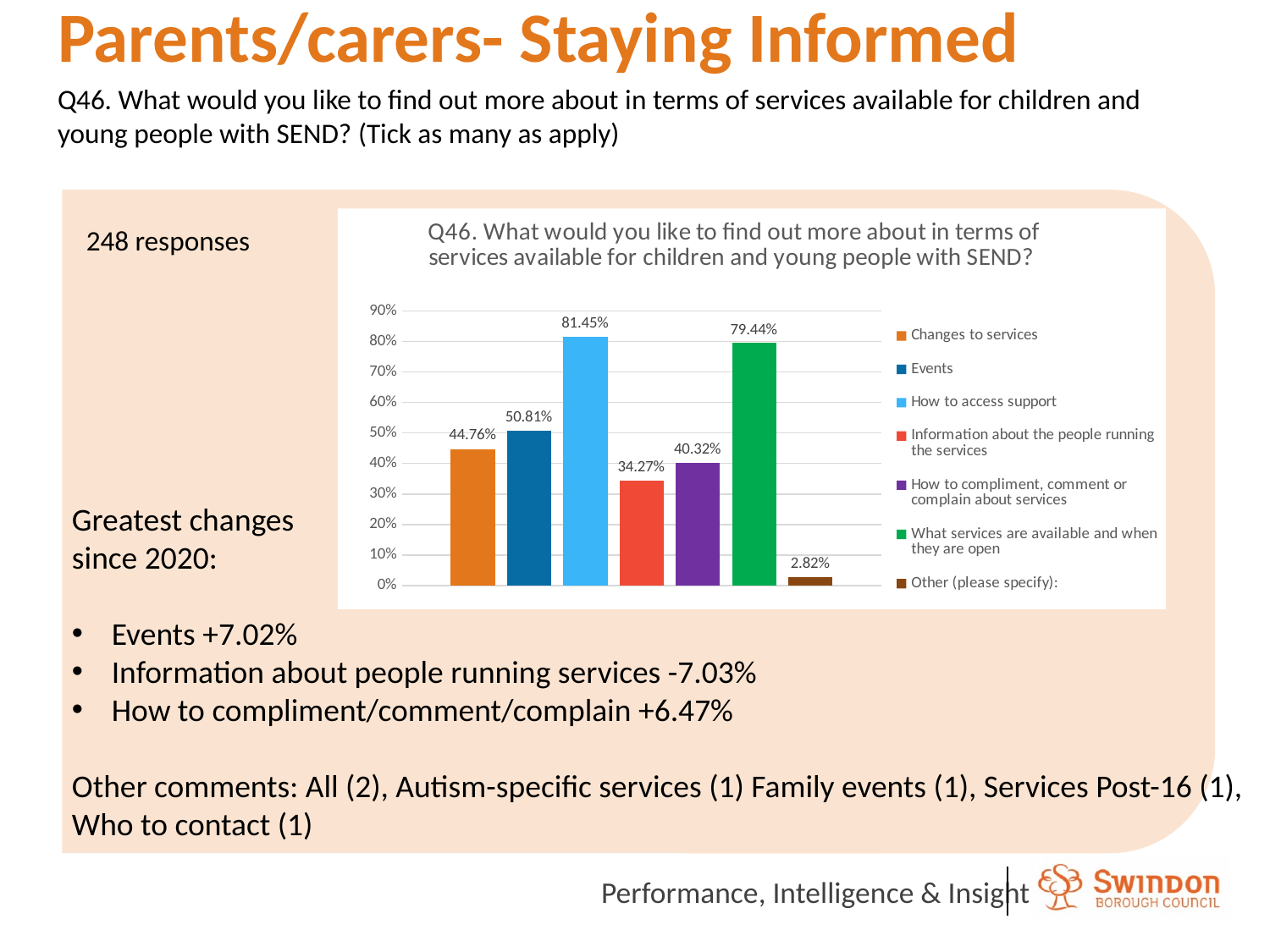
What percentage is shown for 'Information about the people running the services'? 34.27% How many entries does the chart legend list? 7 How many bars are plotted in the chart? 7 What is the value shown for 'Events'? 50.81% What type of chart is shown on the slide? Bar chart What percentage of respondents selected 'How to access support'? 81.45% Which is larger: the value for 'Changes to services' or the value for 'How to compliment, comment or complain about services'? Changes to services Which category has the highest value in the chart? How to access support Is the value for 'Events' greater or less than 60%? less Which category has the lowest value in the chart? Other (please specify): What is the difference between the values for 'How to access support' and 'What services are available and when they are open'? 2.01% What is the value for 'Other (please specify):'? 2.82%